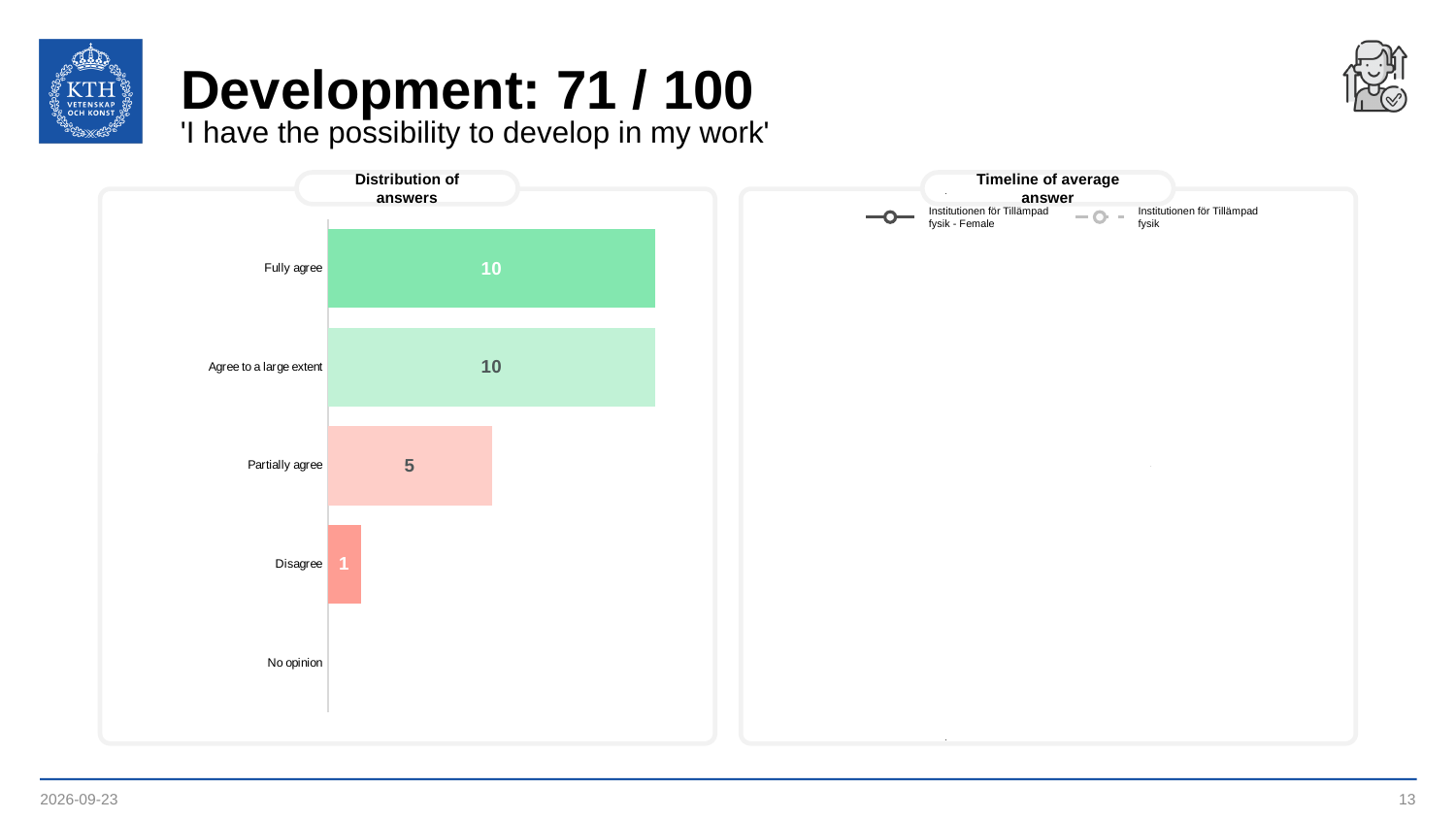
In the 'Distribution of answers' chart, what is the value for 'Partially agree'? 5 In the 'Distribution of answers' chart, which is larger: the value for 'Partially agree' or the value for 'Disagree'? Partially agree How many series does the legend of the 'Timeline of average answer' chart list? 2 What kind of chart is the 'Distribution of answers' chart? Bar chart In the 'Distribution of answers' chart, which is larger: the value for 'Agree to a large extent' or the value for 'Partially agree'? Agree to a large extent In the 'Distribution of answers' chart, what is the value for 'Agree to a large extent'? 10 How many answer categories are listed in the 'Distribution of answers' chart? 5 In the 'Distribution of answers' chart, what is the value for 'Disagree'? 1 What is the title of the chart on the left side of the slide? Distribution of answers In the 'Distribution of answers' chart, what is the difference between the values for 'Fully agree' and 'Partially agree'? 5 In the 'Distribution of answers' chart, what is the difference between the values for 'Partially agree' and 'Disagree'? 4 In the 'Distribution of answers' chart, what is the value for 'Fully agree'? 10